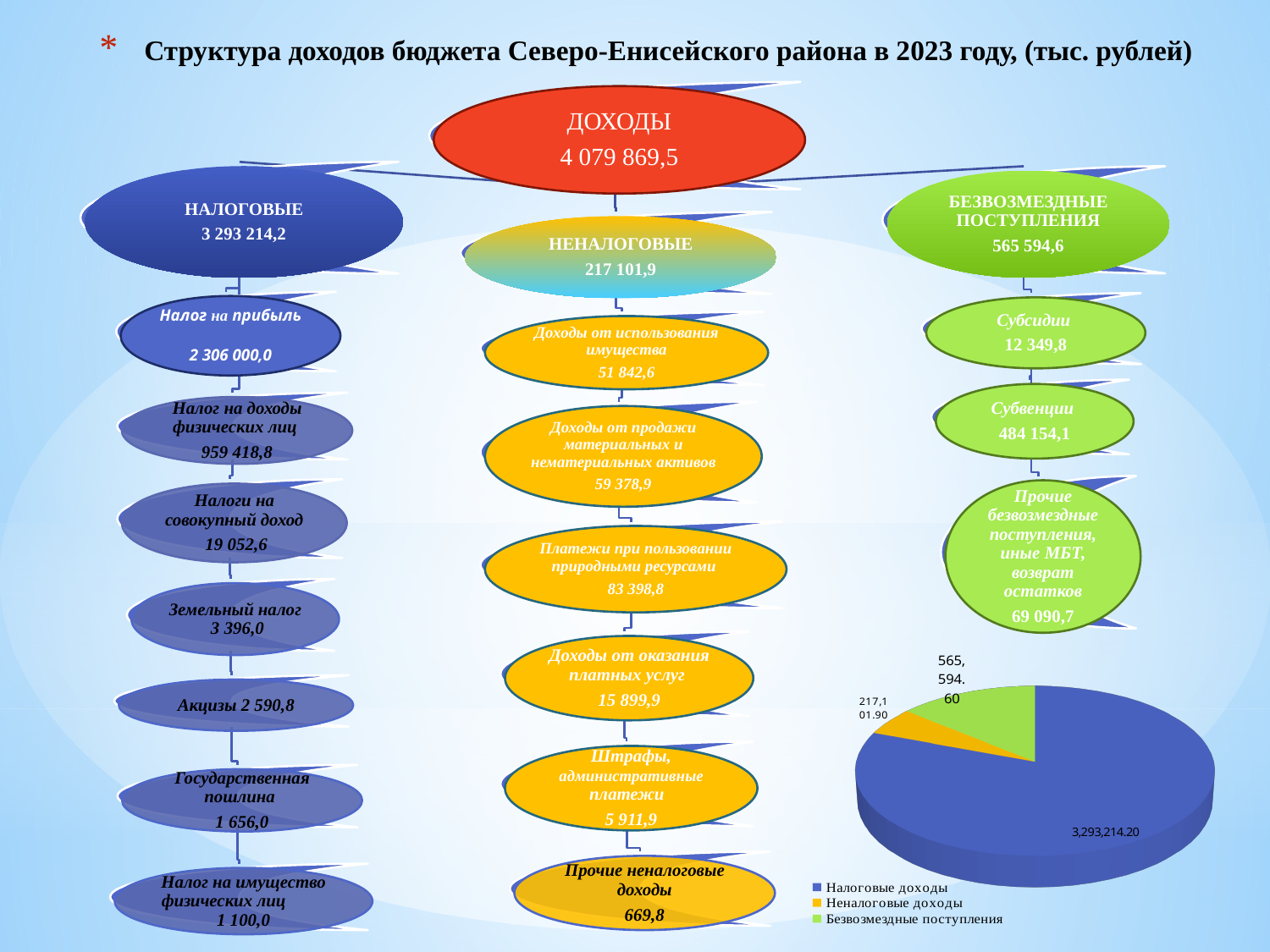
In the pie chart, what is the difference between the Налоговые доходы value and the Безвозмездные поступления value? 2,727,619.60 What colour is the Налоговые доходы slice in the pie chart? blue What value is labelled on the Безвозмездные поступления slice of the pie chart? 565,594.60 How many slices does the pie chart have? 3 In the pie chart, which category has the largest slice? Налоговые доходы What kind of chart is shown in the bottom right of the slide? pie chart In the pie chart, which category has the smallest slice? Неналоговые доходы What value is labelled on the Налоговые доходы slice of the pie chart? 3,293,214.20 In the pie chart, which is larger: Безвозмездные поступления or Неналоговые доходы? Безвозмездные поступления What value is labelled on the Неналоговые доходы slice of the pie chart? 217,101.90 How many entries does the pie chart's legend list? 3 In the pie chart, what is the difference between the Безвозмездные поступления value and the Неналоговые доходы value? 348,492.70